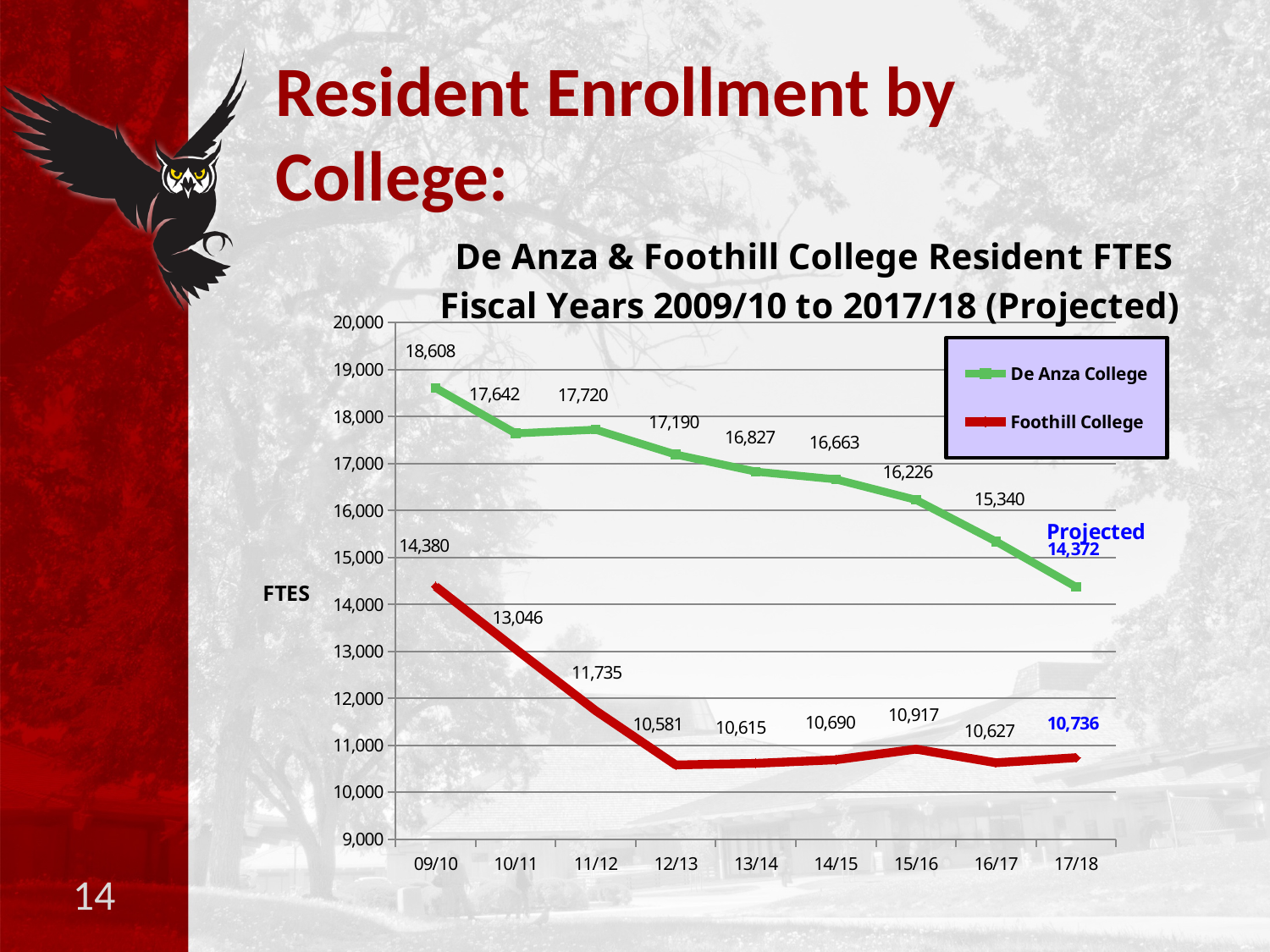
How many series does the legend list? 2 In which fiscal year is the Foothill College FTES value lowest? 12/13 How many fiscal years are shown on the x axis? 9 What is the Foothill College FTES value for 12/13? 10,581 Is the Foothill College FTES value for 10/11 greater or less than 13,000? greater In which fiscal year is the De Anza College FTES value highest? 09/10 What kind of chart is shown on the slide? Line chart What is the De Anza College FTES value for 09/10? 18,608 What is the difference between the De Anza College and Foothill College FTES values in 09/10? 4,228 What is the projected De Anza College FTES value for 17/18? 14,372 Does the De Anza College FTES value generally rise or fall from 09/10 to 17/18? Fall Which college has the larger FTES value in 15/16? De Anza College